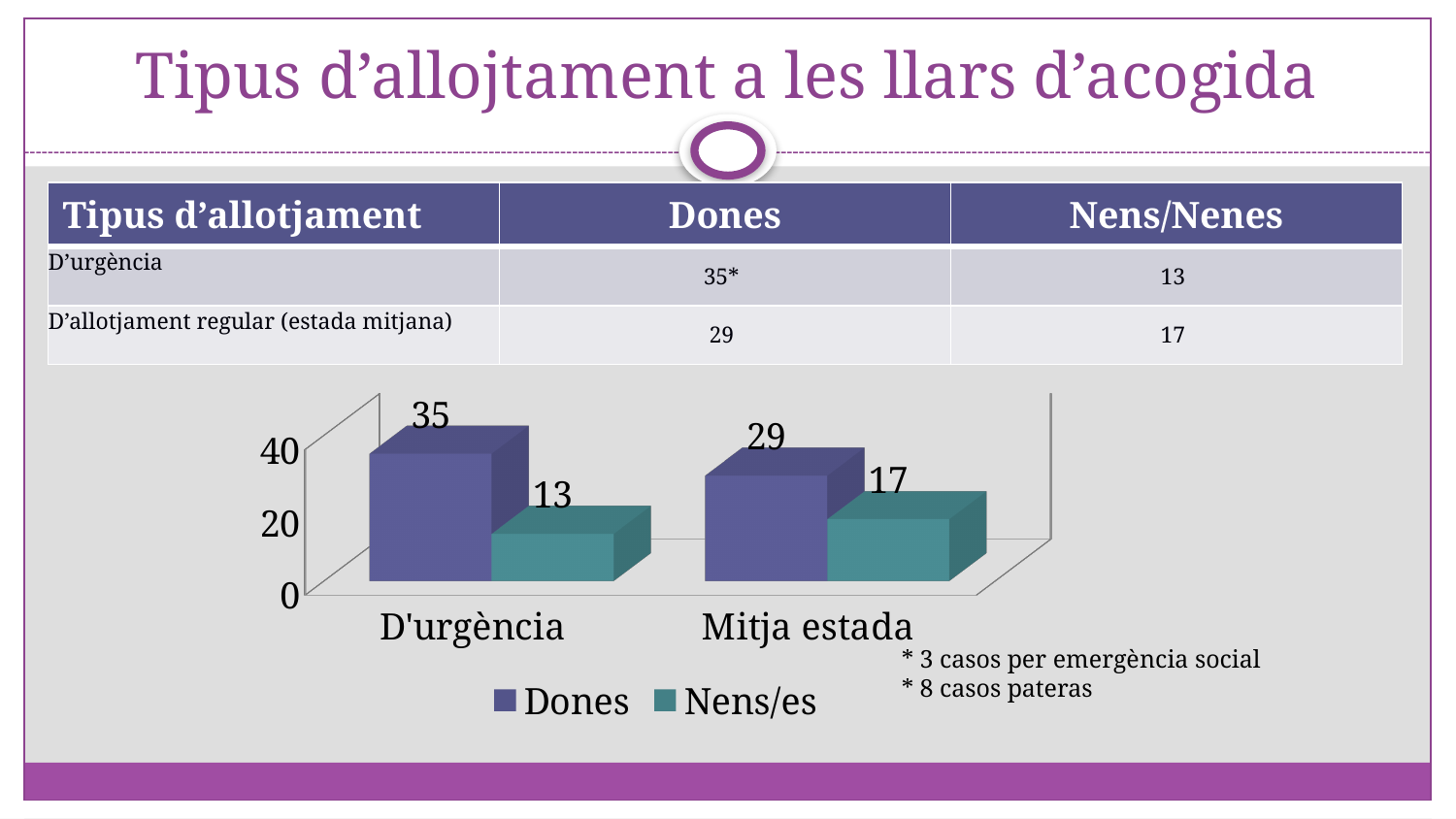
What is the difference between Dones and Nens/es in the D'urgència category? 22 Which bar has the lowest value in the chart? Nens/es, D'urgència What kind of chart is shown on the slide? Bar chart What is the value for Nens/es in the D'urgència category? 13 What is the value for Nens/es in the Mitja estada category? 17 Which bar has the highest value in the chart? Dones, D'urgència How many series does the chart legend list? 2 What is the difference between Dones in D'urgència and Dones in Mitja estada? 6 How many categories are shown on the x axis of the chart? 2 What is the value for Dones in the D'urgència category? 35 Which is larger: Nens/es in D'urgència or Nens/es in Mitja estada? Nens/es in Mitja estada What is the value for Dones in the Mitja estada category? 29